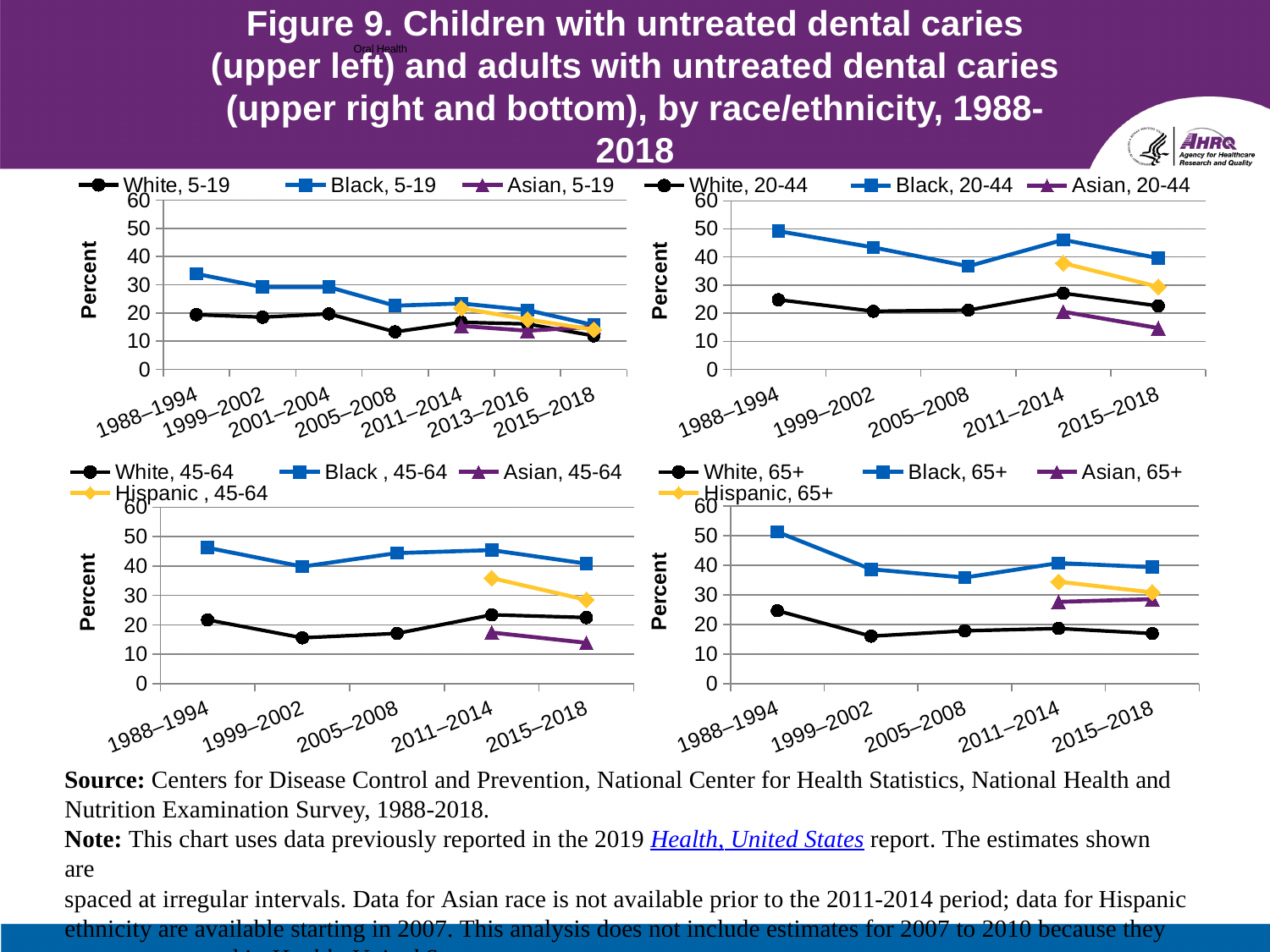
How many time periods are shown on the x axis of the upper-right chart (ages 20-44)? 5 In the lower-left chart (ages 45-64), which is larger in 2015–2018: Black, 45-64 or White, 45-64? Black, 45-64 How many series does the legend list for the lower-left chart (ages 45-64)? 4 In the lower-right chart (ages 65+), in which period is the Black, 65+ value highest? 1988–1994 What type of chart is the upper-left chart (ages 5-19)? Line chart How many time periods are shown on the x axis of the upper-left chart (ages 5-19)? 7 How many series does the legend list for the lower-right chart (ages 65+)? 4 In the upper-left chart (ages 5-19), is the value for White, 5-19 in 1988–1994 greater or less than 30? less In the upper-right chart (ages 20-44), in which period is the Black, 20-44 value highest? 1988–1994 In the lower-right chart (ages 65+), is the value for Black, 65+ in 1988–1994 greater or less than 40? greater In the upper-right chart (ages 20-44), is the value for Black, 20-44 in 1988–1994 greater or less than 40? greater In the upper-left chart (ages 5-19), does the Black, 5-19 line generally rise or fall from 1988–1994 to 2015–2018? Fall